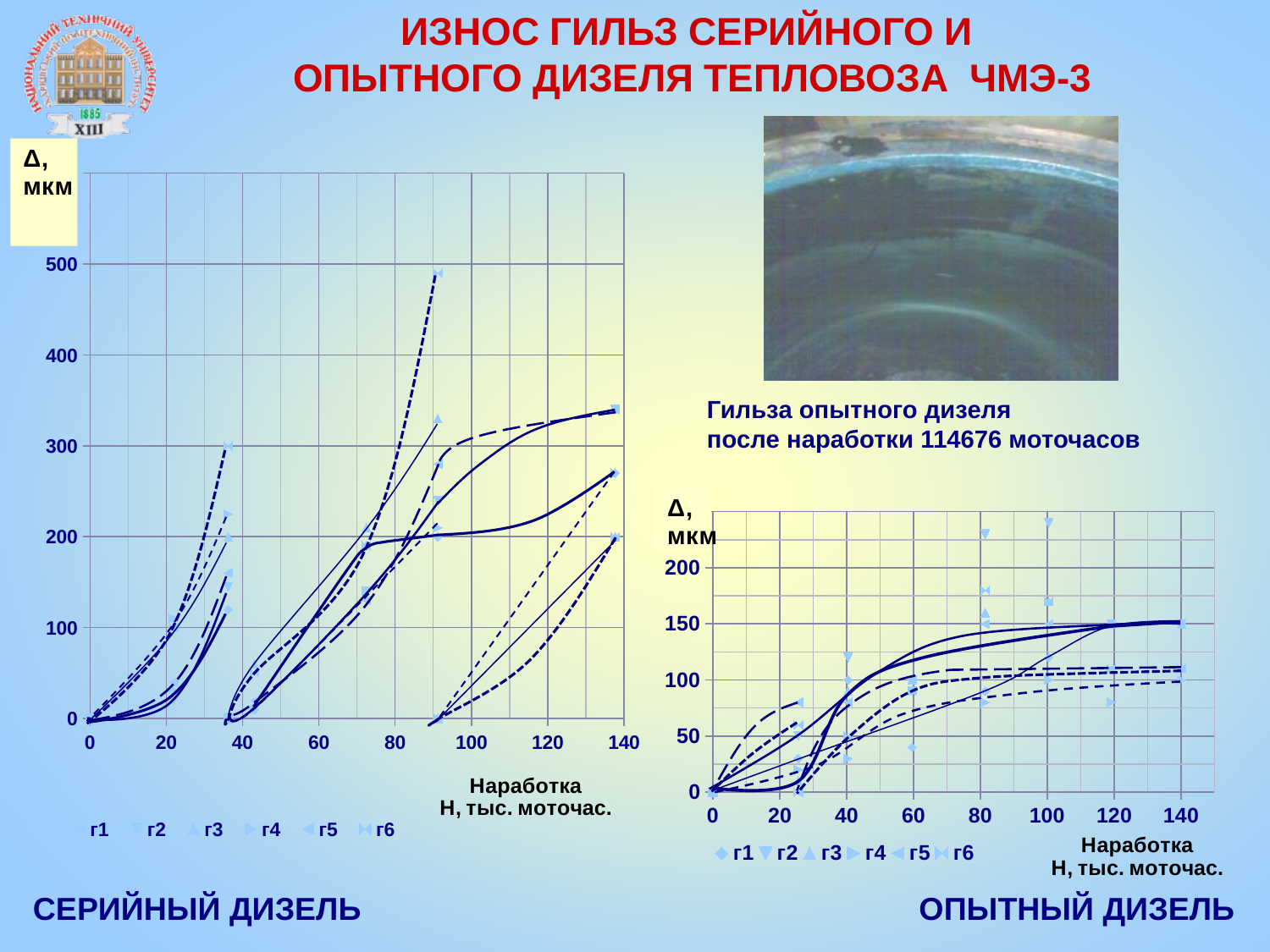
What are the legend entries of the right chart (ОПЫТНЫЙ ДИЗЕЛЬ)? г1, г2, г3, г4, г5, г6 How many series does the legend of the left chart (СЕРИЙНЫЙ ДИЗЕЛЬ) list? 6 On the right chart (ОПЫТНЫЙ ДИЗЕЛЬ), do the wear values generally rise or fall as operating hours increase along the x axis? rise On the right chart (ОПЫТНЫЙ ДИЗЕЛЬ), is the value of the thick solid line at 140 thousand engine-hours greater or less than 100? greater How many series does the legend of the right chart (ОПЫТНЫЙ ДИЗЕЛЬ) list? 6 What kind of chart is the right chart (ОПЫТНЫЙ ДИЗЕЛЬ)? line chart What kind of chart is the left chart (СЕРИЙНЫЙ ДИЗЕЛЬ)? line chart Which chart has the larger maximum value on its vertical axis, the left chart (СЕРИЙНЫЙ ДИЗЕЛЬ) or the right chart (ОПЫТНЫЙ ДИЗЕЛЬ)? the left chart (СЕРИЙНЫЙ ДИЗЕЛЬ) On the left chart (СЕРИЙНЫЙ ДИЗЕЛЬ), is the highest plotted wear value greater or less than 400? greater On the left chart (СЕРИЙНЫЙ ДИЗЕЛЬ), do the wear values rise or fall as operating hours increase within each curve? rise What is the highest tick value on the vertical axis of the left chart (СЕРИЙНЫЙ ДИЗЕЛЬ)? 500 On the right chart (ОПЫТНЫЙ ДИЗЕЛЬ), is the value of the lowest dashed line at 140 thousand engine-hours greater or less than 50? greater